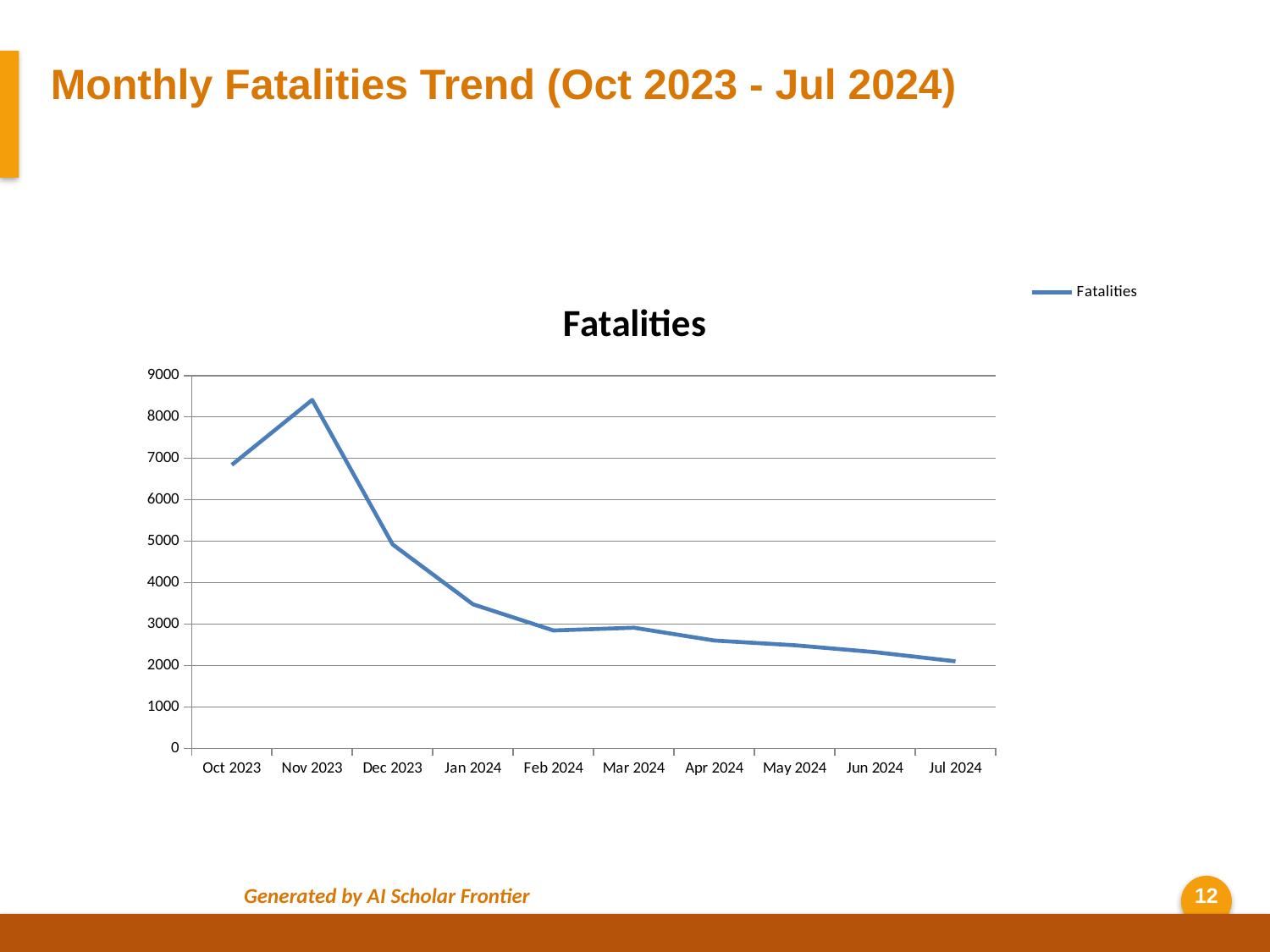
Which month has the lowest number of fatalities? Jul 2024 How many series does the legend list? 1 What kind of chart is shown on the slide? line chart Is the value for Jul 2024 greater or less than 3000? less Is the value for Dec 2023 greater or less than 6000? less What is the title of the chart? Fatalities Do the fatalities rise or fall from Nov 2023 to Jul 2024? fall Is the value for Nov 2023 greater or less than 8000? greater Which month has the highest number of fatalities? Nov 2023 Which is larger, the value for Oct 2023 or the value for Dec 2023? Oct 2023 How many months are plotted on the x axis? 10